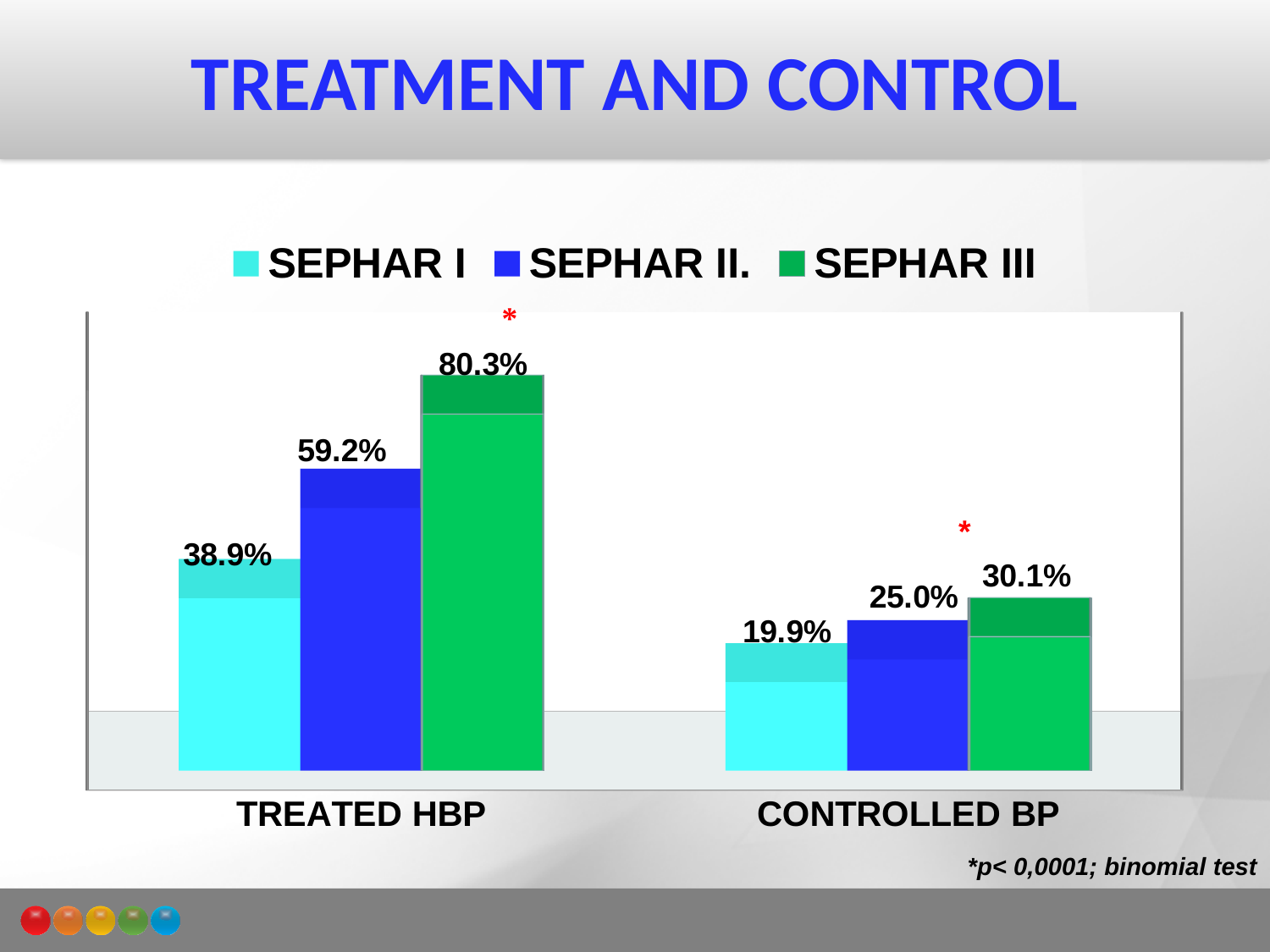
What is the difference between the SEPHAR III and SEPHAR I values in the TREATED HBP category? 41.4% What is the value for SEPHAR I in the CONTROLLED BP category? 19.9% Which series has the lowest value in the CONTROLLED BP category? SEPHAR I What is the value for SEPHAR II. in the TREATED HBP category? 59.2% Which series has the highest value in the TREATED HBP category? SEPHAR III Which is larger: the SEPHAR I value for TREATED HBP or the SEPHAR III value for CONTROLLED BP? SEPHAR I value for TREATED HBP What is the value for SEPHAR II. in the CONTROLLED BP category? 25.0% What is the value for SEPHAR III in the TREATED HBP category? 80.3% What is the difference between the SEPHAR III and SEPHAR II. values in the CONTROLLED BP category? 5.1% How many series does the legend list? 3 What kind of chart is shown on the slide? Bar chart How many categories are shown on the x axis? 2